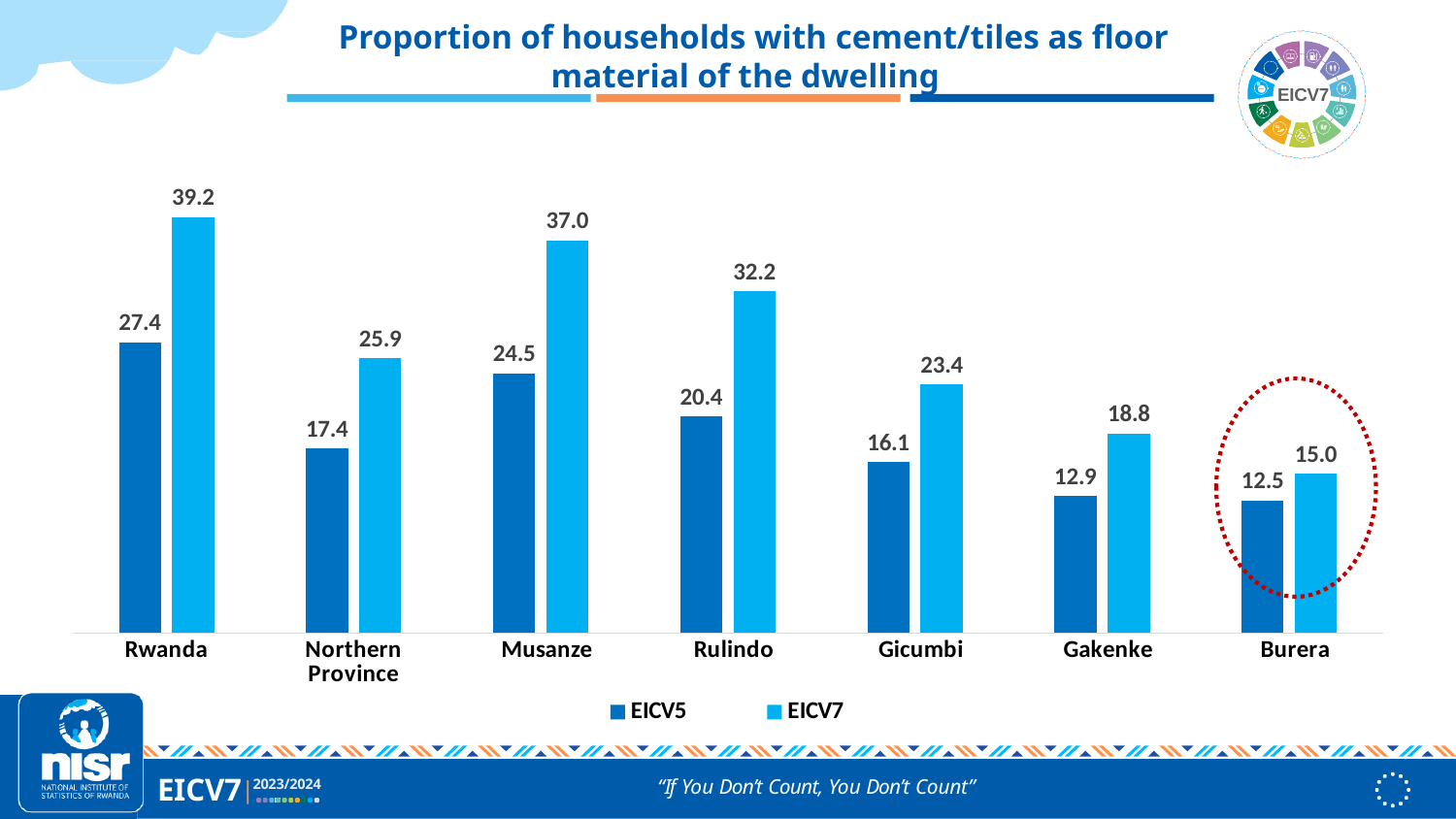
Which category is highlighted with a red dotted circle? Burera Which is larger, the EICV7 value for Gicumbi or the EICV7 value for Northern Province? Northern Province How many series does the legend list? 2 Which category has the lowest EICV5 value? Burera What is the title of the chart? Proportion of households with cement/tiles as floor material of the dwelling How many categories are shown on the x axis? 7 What kind of chart is shown on the slide? Bar chart Which category has the highest EICV7 value? Rwanda What is the EICV5 value for Musanze? 24.5 What is the EICV7 value for Rwanda? 39.2 What is the EICV7 value for Burera? 15.0 What is the difference between the EICV7 and EICV5 values for Rulindo? 11.8